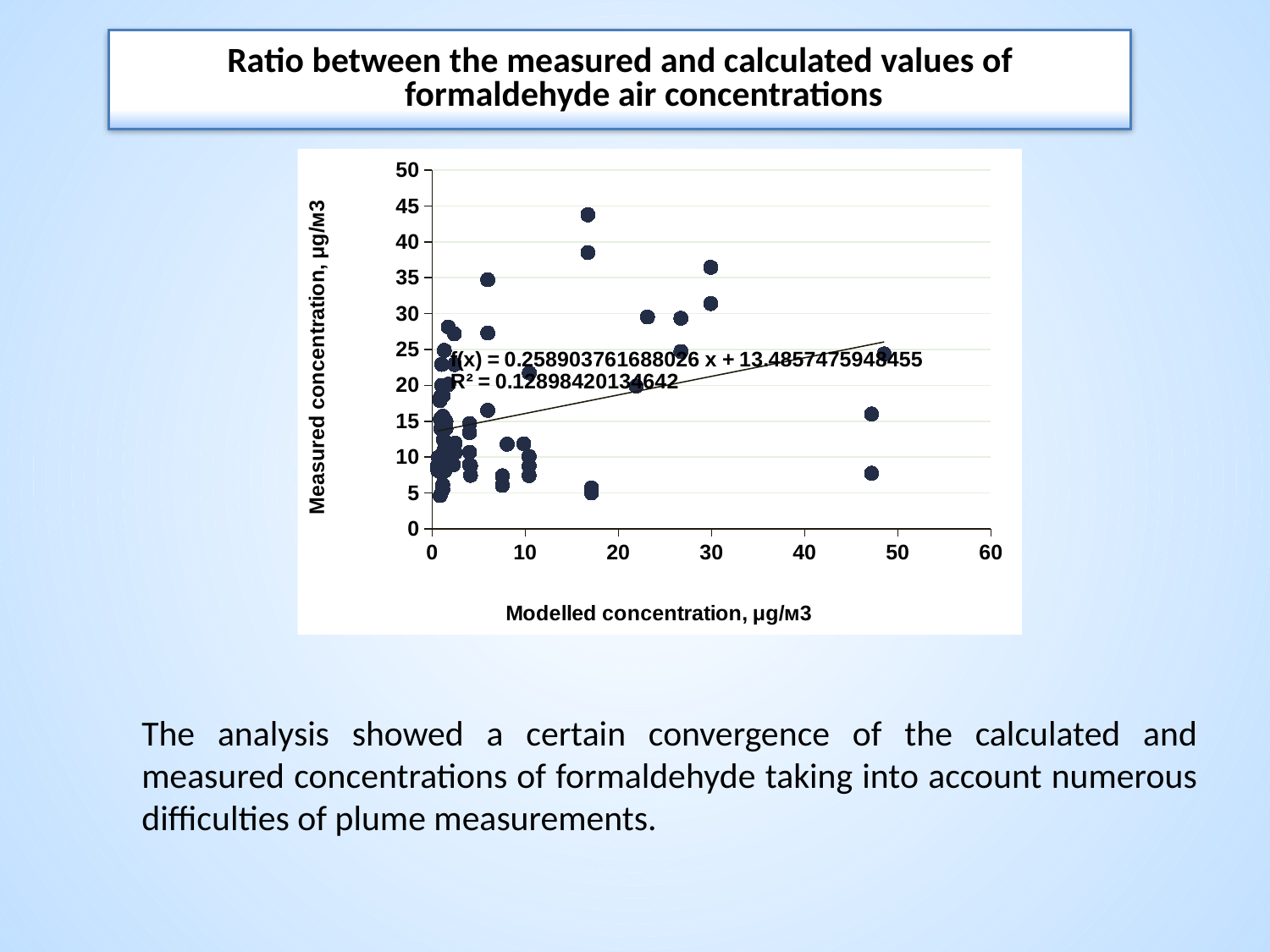
Is the highest measured concentration plotted on the chart greater or less than 40? greater Does the fitted trendline rise or fall as modelled concentration increases? rise What is the maximum value shown on the y axis of the chart? 50 What is the slope of the fitted trendline shown in the chart equation? 0.258903761688026 What kind of chart is shown on the slide? Scatter plot What is the label of the x axis of the chart? Modelled concentration, µg/м3 What is the maximum value shown on the x axis of the chart? 60 Is the largest modelled concentration plotted on the chart greater or less than 40? greater What R² value is printed on the chart? 0.12898420134642 What is the title of the chart on the slide? Ratio between the measured and calculated values of formaldehyde air concentrations Is the lowest measured concentration plotted on the chart greater or less than 10? less What is the intercept of the fitted trendline shown in the chart equation? 13.4857475948455